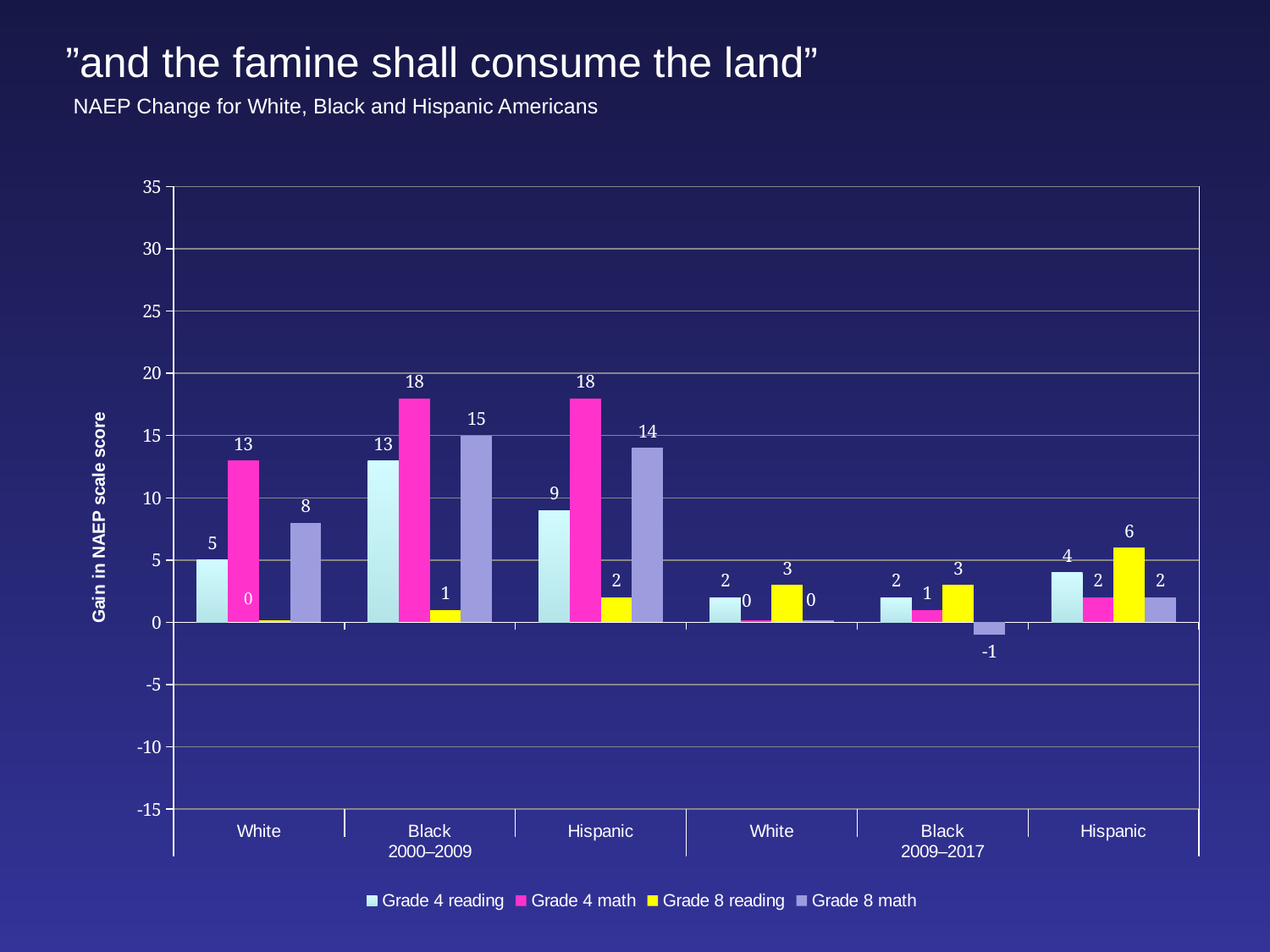
What is the Grade 8 math value for Black students in 2009–2017? -1 What is the difference between the Grade 4 math gain for Black students in 2000–2009 and in 2009–2017? 17 What is the Grade 4 reading gain for Hispanic students in 2000–2009? 9 For Hispanic students in 2009–2017, which is larger: the Grade 8 reading gain or the Grade 4 reading gain? Grade 8 reading What is the Grade 8 math gain for White students in 2000–2009? 8 What kind of chart is shown on the slide? Bar chart What is the Grade 4 math gain for Black students in 2000–2009? 18 How many category groups are shown along the x axis? 6 What is the title of the vertical axis? Gain in NAEP scale score Which group had the highest Grade 8 math gain in 2000–2009? Black Which bar shows the lowest value on the chart? Grade 8 math for Black students in 2009–2017 How many series does the legend list? 4